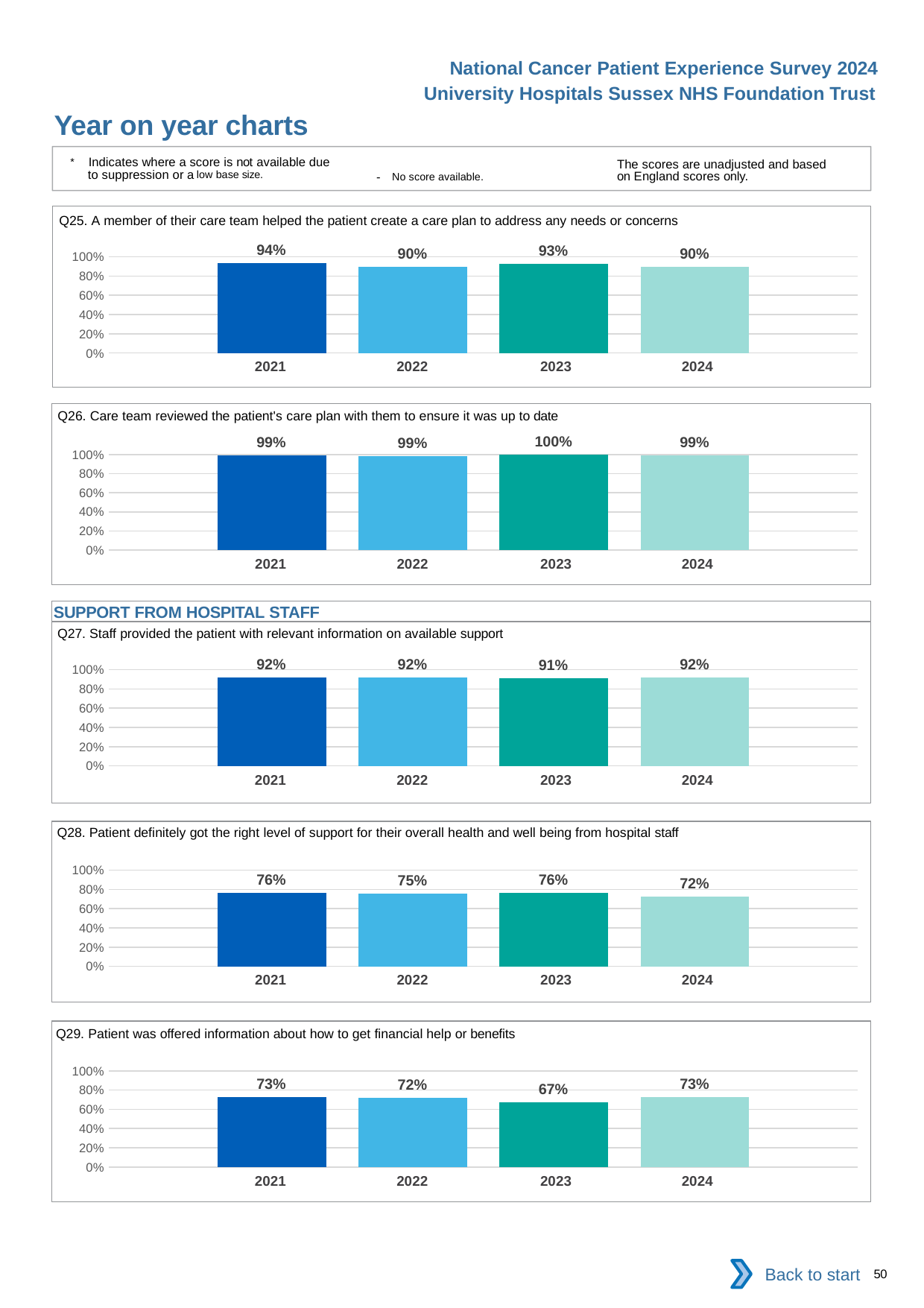
In the Q27 chart, what is the value for 2023? 91% In the Q28 chart, which year has the lowest value? 2024 How many bars are shown in the Q27 chart? 4 In the Q25 chart, which is larger, the value for 2021 or the value for 2022? 2021 In the Q28 chart, is the value for 2024 greater or less than 80%? less In the Q29 chart, what is the value for 2023? 67% In the Q29 chart, what is the difference between the 2021 value and the 2023 value? 6% What kind of chart is the Q29 chart? bar chart What section heading appears above the Q27 chart? SUPPORT FROM HOSPITAL STAFF In the Q25 chart, what is the value for 2021? 94% In the Q28 chart, what is the difference between the 2021 value and the 2024 value? 4% In the Q26 chart, which year has the highest value? 2023